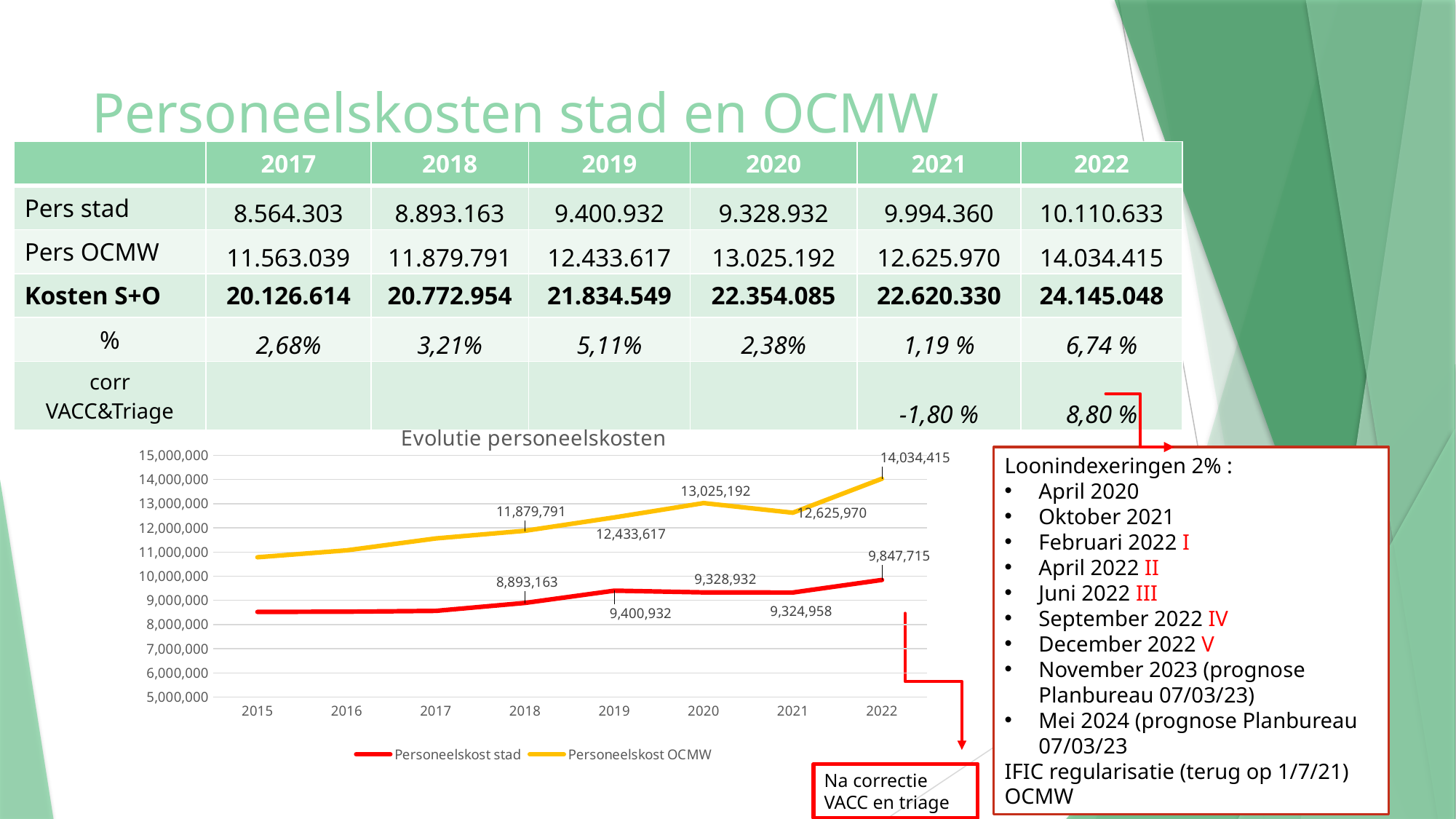
In which year is Personeelskost OCMW highest? 2022 Is the value for Personeelskost OCMW in 2015 greater or less than 11,000,000? less What is the value of Personeelskost stad in 2019? 9,400,932 What is the value of Personeelskost OCMW in 2022? 14,034,415 What is the value of Personeelskost OCMW in 2020? 13,025,192 Which is larger: Personeelskost stad in 2019 or in 2020? 2019 What is the difference between Personeelskost OCMW in 2022 and in 2021? 1,408,445 What kind of chart is shown on the slide? line chart In which year is Personeelskost OCMW lowest? 2015 What is the value of Personeelskost stad in 2022? 9,847,715 How many years are shown on the x axis of the chart? 8 How many series does the chart legend list? 2